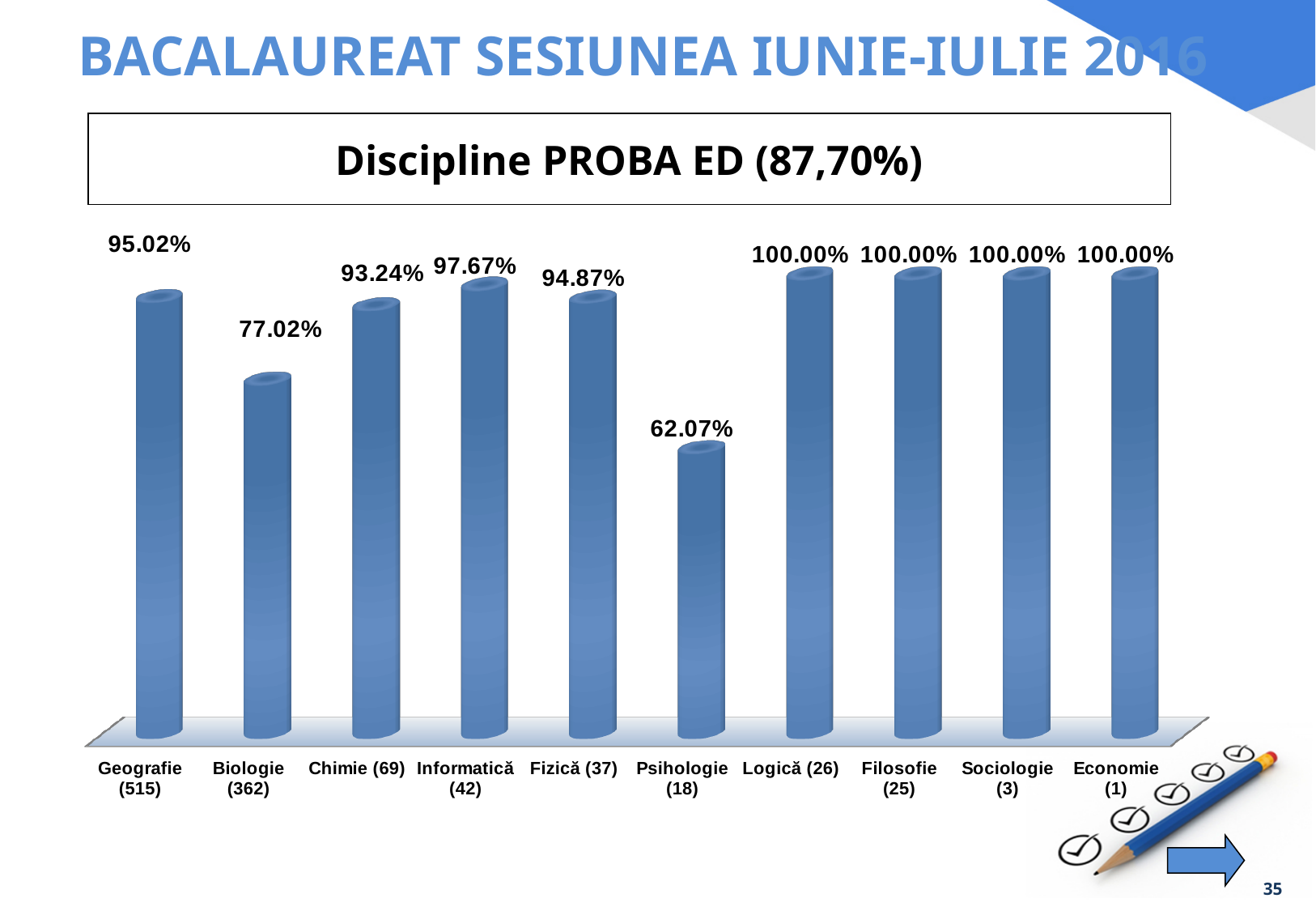
How many categories have a value of 100.00%? 4 How many categories are shown in the chart? 10 What is the value for Geografie (515)? 95.02% Which category has the lowest value? Psihologie (18) What is the difference between the values for Geografie (515) and Biologie (362)? 18.00% What is the value for Informatică (42)? 97.67% What is the value for Psihologie (18)? 62.07% What kind of chart is shown on the slide? Bar chart What is the difference between the values for Informatică (42) and Chimie (69)? 4.43% What is the title of the chart? Discipline PROBA ED (87,70%) Which is larger, the value for Fizică (37) or the value for Chimie (69)? Fizică (37) What is the value for Biologie (362)? 77.02%